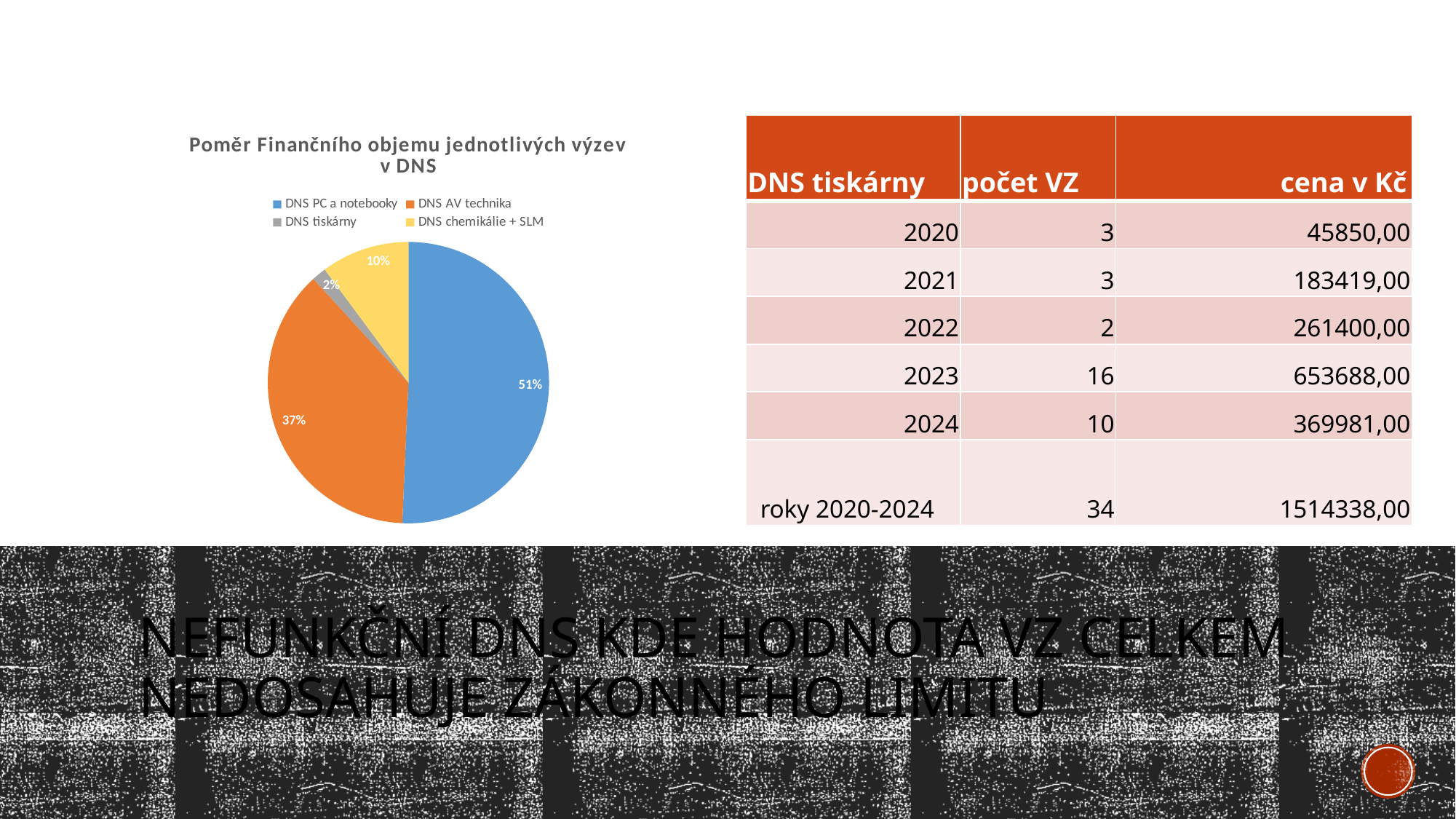
What share of the pie does DNS chemikálie + SLM have? 10% Which colour represents DNS AV technika in the pie chart? orange What share of the pie does DNS AV technika have? 37% Which category has the smallest slice of the pie? DNS tiskárny What is the difference in percentage points between DNS PC a notebooky and DNS AV technika? 14 What is the title of the pie chart? Poměr Finančního objemu jednotlivých výzev v DNS Which category has the largest slice of the pie? DNS PC a notebooky What kind of chart is shown on the slide? pie chart What share of the pie does DNS tiskárny have? 2% How many slices does the pie chart have? 4 Which is larger, the share for DNS chemikálie + SLM or the share for DNS tiskárny? DNS chemikálie + SLM